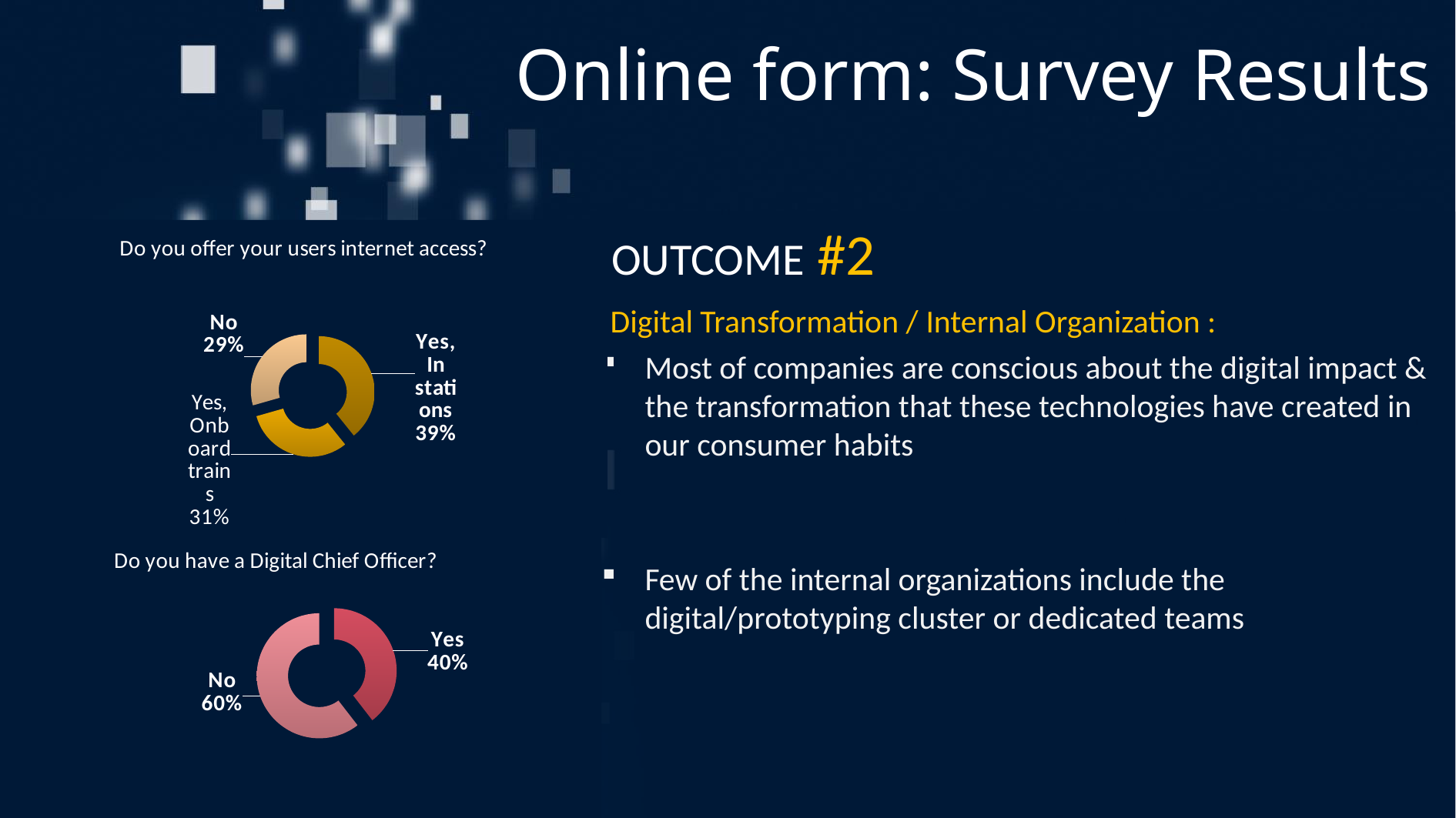
In the 'Do you offer your users internet access?' chart, what share of respondents answered 'No'? 29% What type of chart is used for 'Do you have a Digital Chief Officer?'? Doughnut (pie) chart In the 'Do you offer your users internet access?' chart, which response has the largest share? Yes, In stations In the 'Do you offer your users internet access?' chart, what is the difference in percentage points between 'Yes, In stations' and 'No'? 10 percentage points In the 'Do you have a Digital Chief Officer?' chart, which answer is larger, 'Yes' or 'No'? No In the 'Do you offer your users internet access?' chart, which response has the smallest share? No In the 'Do you have a Digital Chief Officer?' chart, what share of respondents answered 'No'? 60% In the 'Do you have a Digital Chief Officer?' chart, what share of respondents answered 'Yes'? 40% In the 'Do you offer your users internet access?' chart, what share of respondents answered 'Yes, Onboard trains'? 31% In the 'Do you have a Digital Chief Officer?' chart, what is the difference in percentage points between 'No' and 'Yes'? 20 percentage points In the 'Do you offer your users internet access?' chart, what share of respondents answered 'Yes, In stations'? 39% In the 'Do you offer your users internet access?' chart, how many response categories are shown? 3